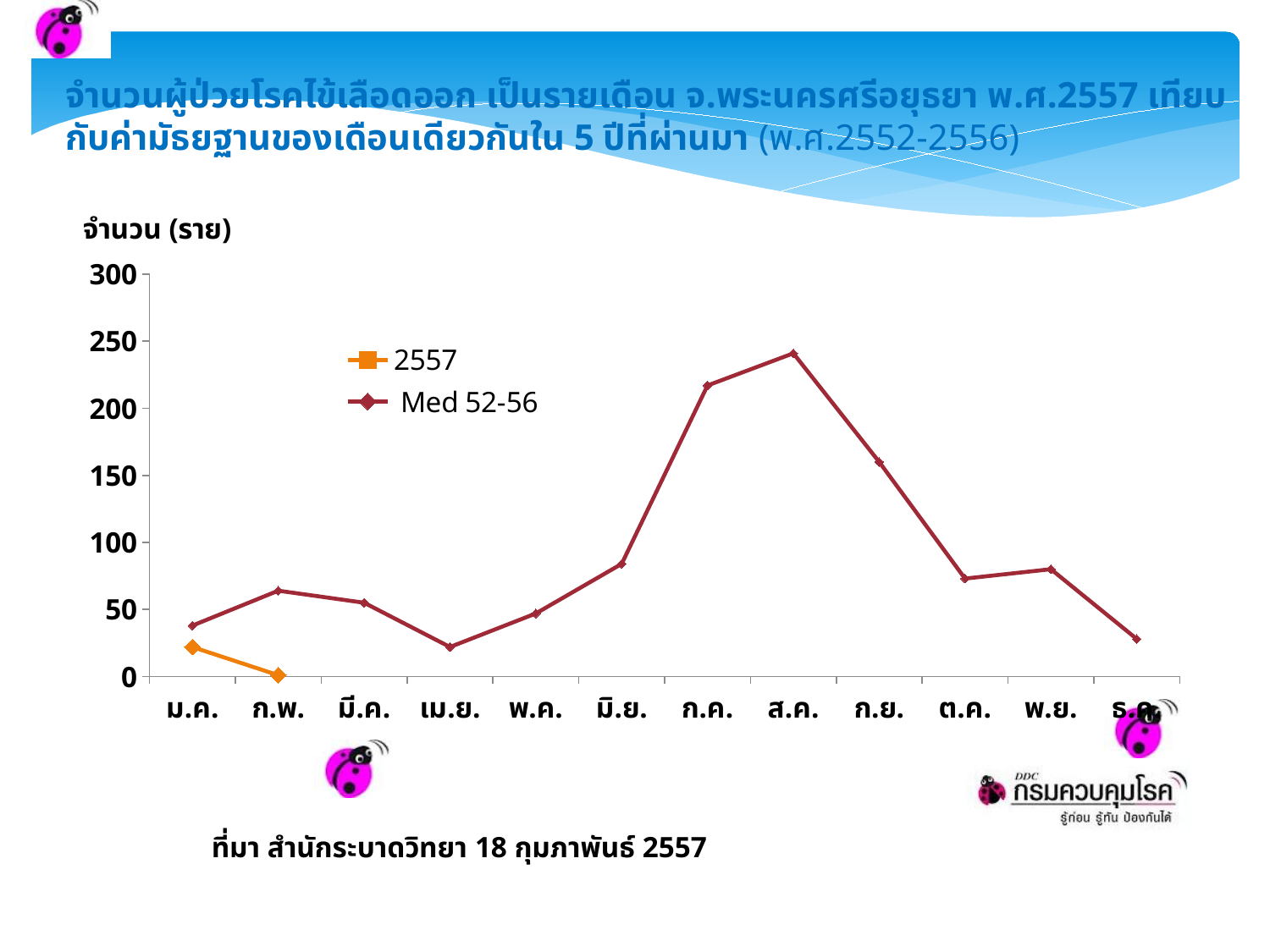
What are the two series named in the legend? 2557 and Med 52-56 Does the Med 52-56 series rise or fall from ส.ค. to ธ.ค.? fall What is the label on the y axis of the chart? จำนวน (ราย) How many months are shown along the x axis? 12 How many series does the legend list? 2 What kind of chart is shown on the slide? line chart Is the Med 52-56 value for ส.ค. greater or less than 200? greater Is the Med 52-56 value for เม.ย. greater or less than 50? less Which is larger for the Med 52-56 series, the value for ส.ค. or the value for ก.ย.? ส.ค. Is the Med 52-56 value for ต.ค. greater or less than 100? less How many data points are plotted for the 2557 series? 2 In which month does the Med 52-56 series reach its highest value? ส.ค.